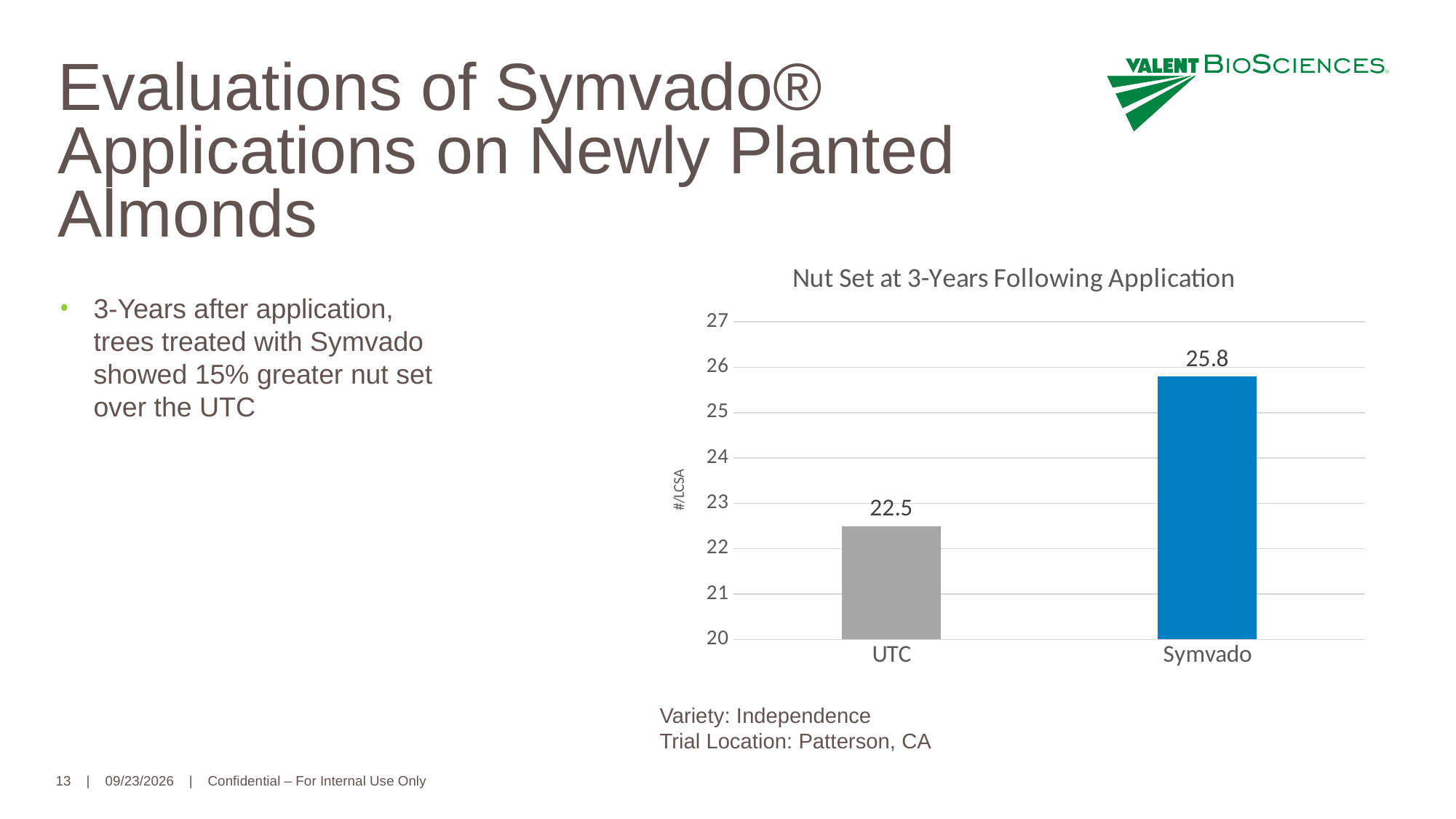
What kind of chart is shown? bar chart What is the value for UTC? 22.5 What is the difference between the Symvado and UTC values? 3.3 How many categories are shown on the x axis? 2 What is the y-axis label of the chart? #/LCSA What is the title of the chart? Nut Set at 3-Years Following Application Is the value for Symvado greater or less than 25? greater What is the value for Symvado? 25.8 Is the value for UTC greater or less than 23? less Which category has the lowest value? UTC Which is larger, the value for UTC or the value for Symvado? Symvado Which category has the highest value? Symvado